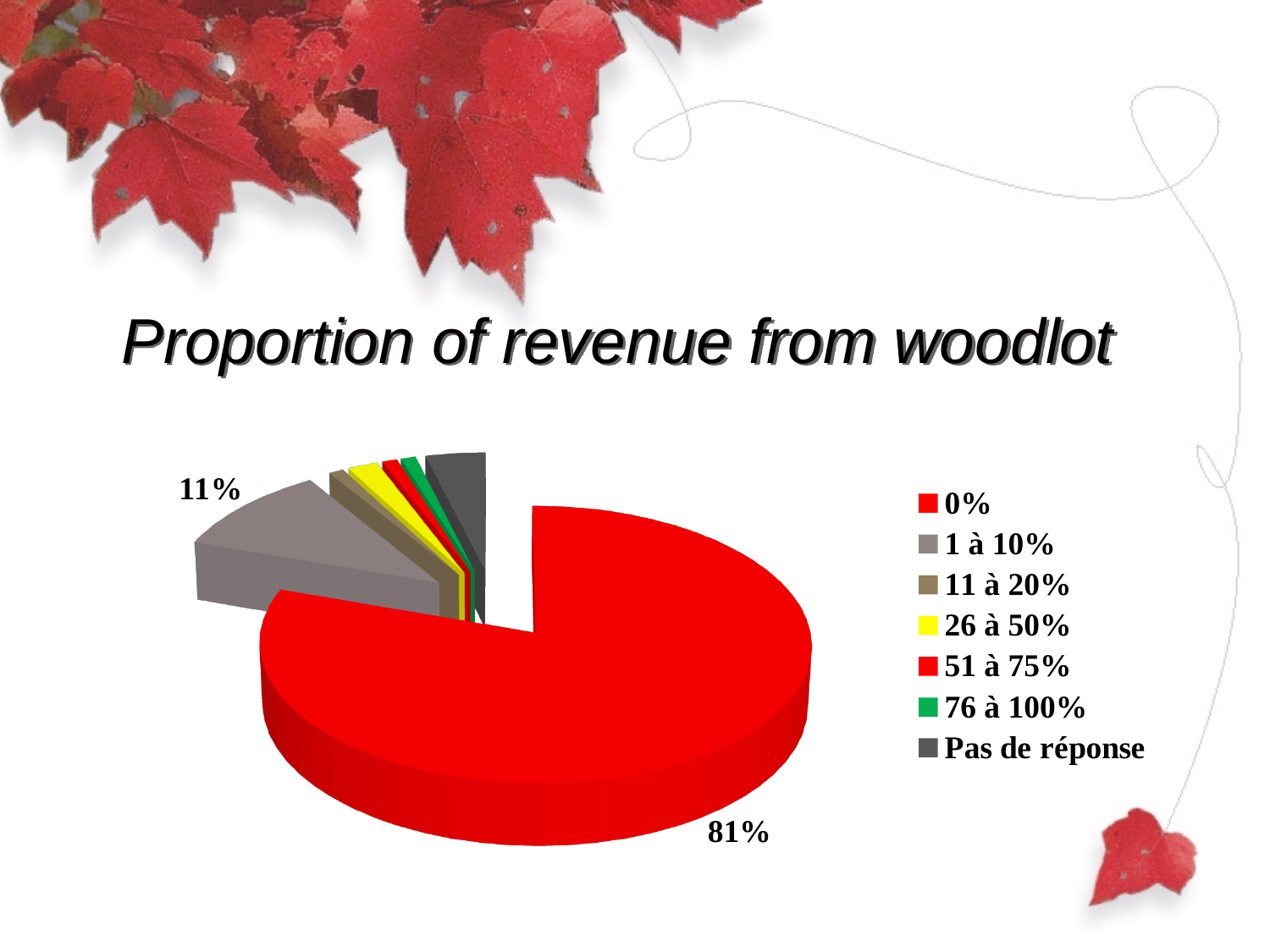
What is the difference between the share of the "0%" slice and the "1 à 10%" slice? 70% What share of the pie does the "1 à 10%" category represent? 11% Which slice is larger, "1 à 10%" or "26 à 50%"? 1 à 10% Which category has the largest slice of the pie? 0% What share of the pie does the "0%" category represent? 81% Which slice is larger, "0%" or "1 à 10%"? 0% How many categories does the legend list? 7 Which legend category is shown in green? 76 à 100% What kind of chart is shown on the slide? Pie chart What is the title of the chart? Proportion of revenue from woodlot